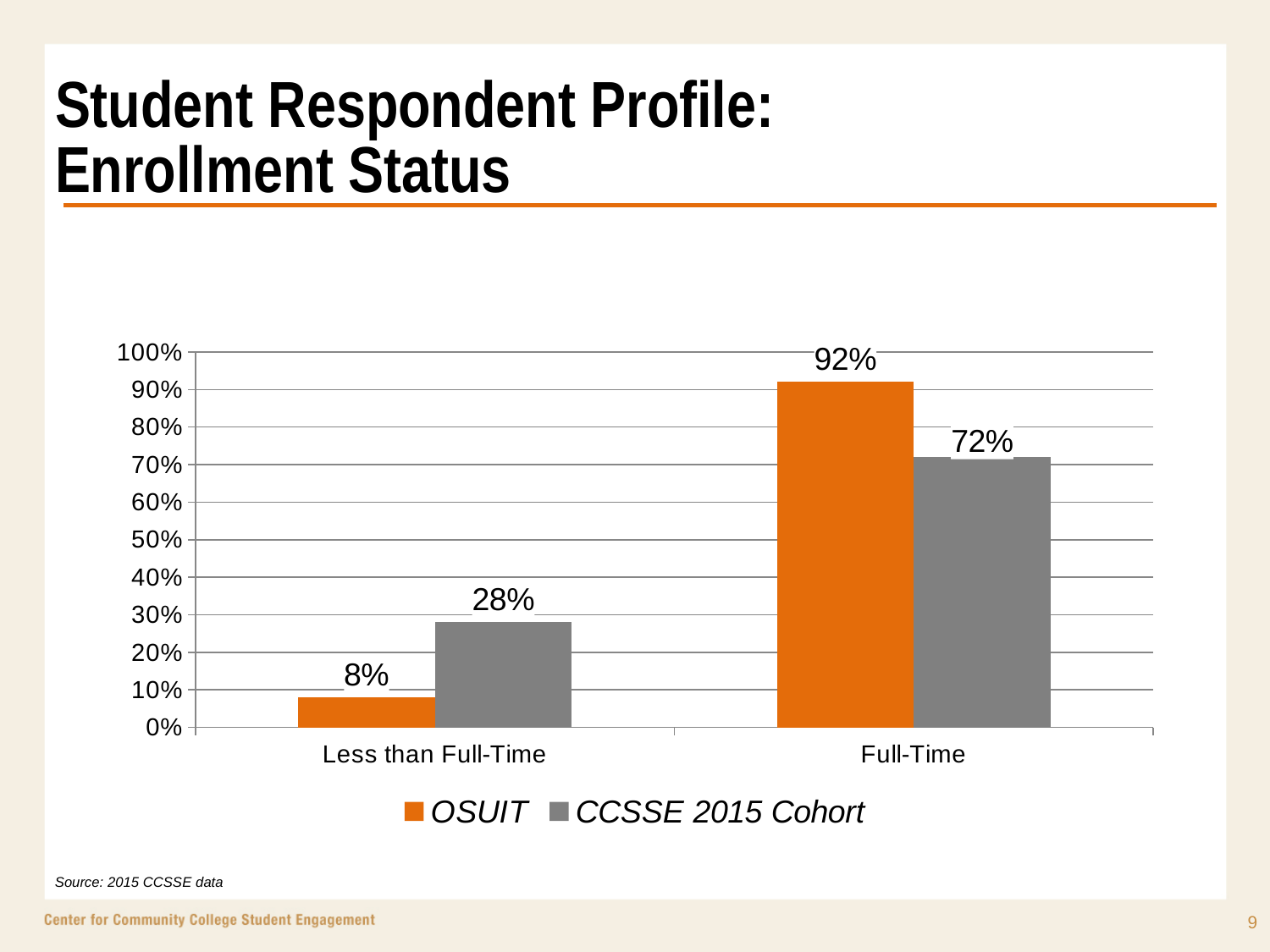
Which category has the lowest CCSSE 2015 Cohort value? Less than Full-Time What is the difference between the OSUIT and CCSSE 2015 Cohort values for Full-Time? 20% What is the CCSSE 2015 Cohort value for Less than Full-Time? 28% Which is larger for Less than Full-Time: OSUIT or CCSSE 2015 Cohort? CCSSE 2015 Cohort What is the OSUIT value for Full-Time? 92% How many series does the legend list? 2 What is the difference between the CCSSE 2015 Cohort and OSUIT values for Less than Full-Time? 20% What is the OSUIT value for Less than Full-Time? 8% Which category has the highest OSUIT value? Full-Time How many categories are shown on the x axis? 2 What is the CCSSE 2015 Cohort value for Full-Time? 72% What kind of chart is shown on the slide? Bar chart